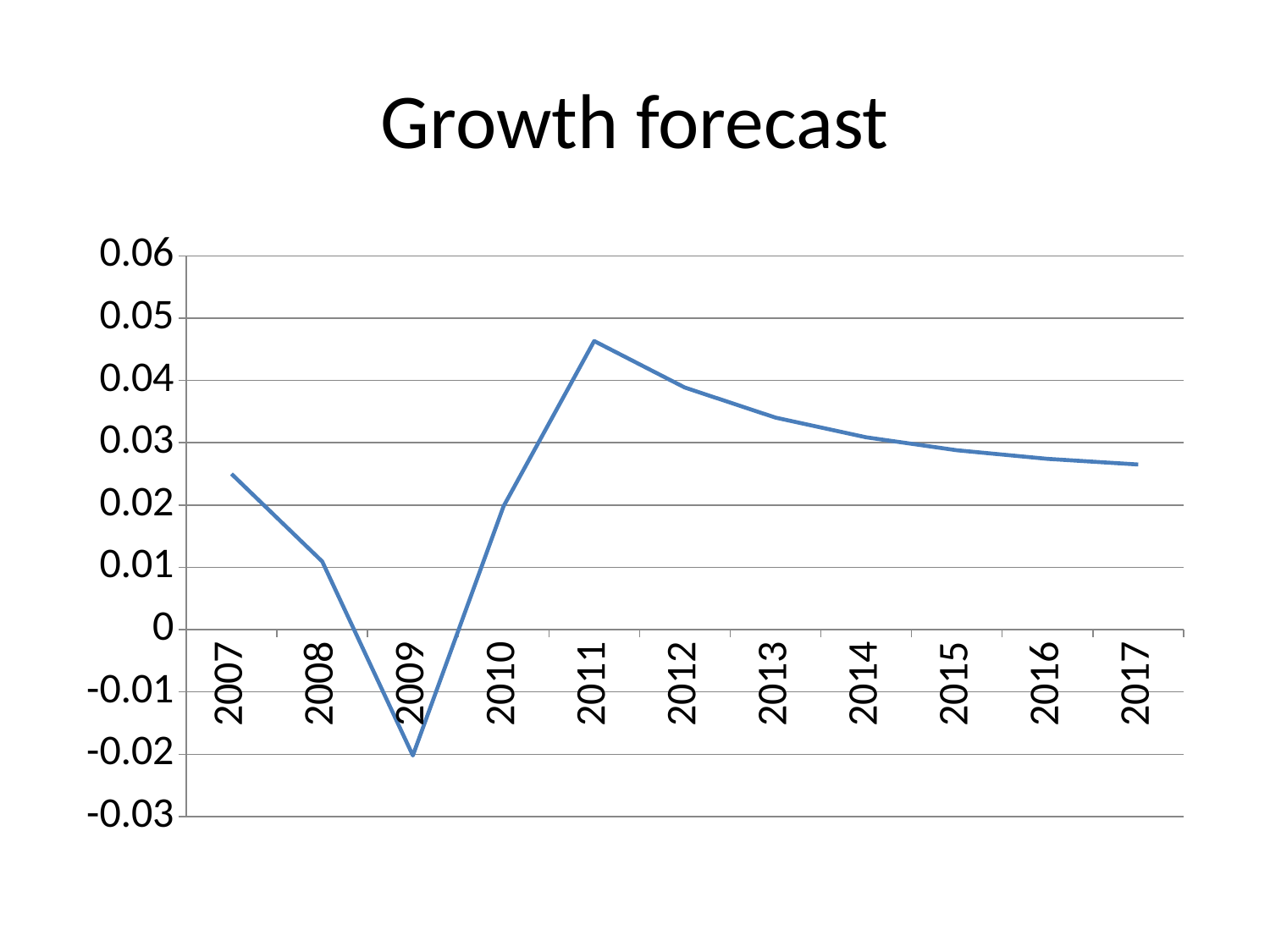
Which year has the highest value? 2011 Which year has the larger value, 2007 or 2008? 2007 What is the title of the chart? Growth forecast Which year has the larger value, 2012 or 2016? 2012 Is the value for 2008 greater or less than 0.02? less How many years are plotted along the x axis? 11 Do the values rise or fall from 2011 to 2017? fall Is the value for 2011 greater or less than 0.04? greater What kind of chart is shown on the slide? line chart Is the value for 2009 greater or less than 0? less Which year has the lowest value? 2009